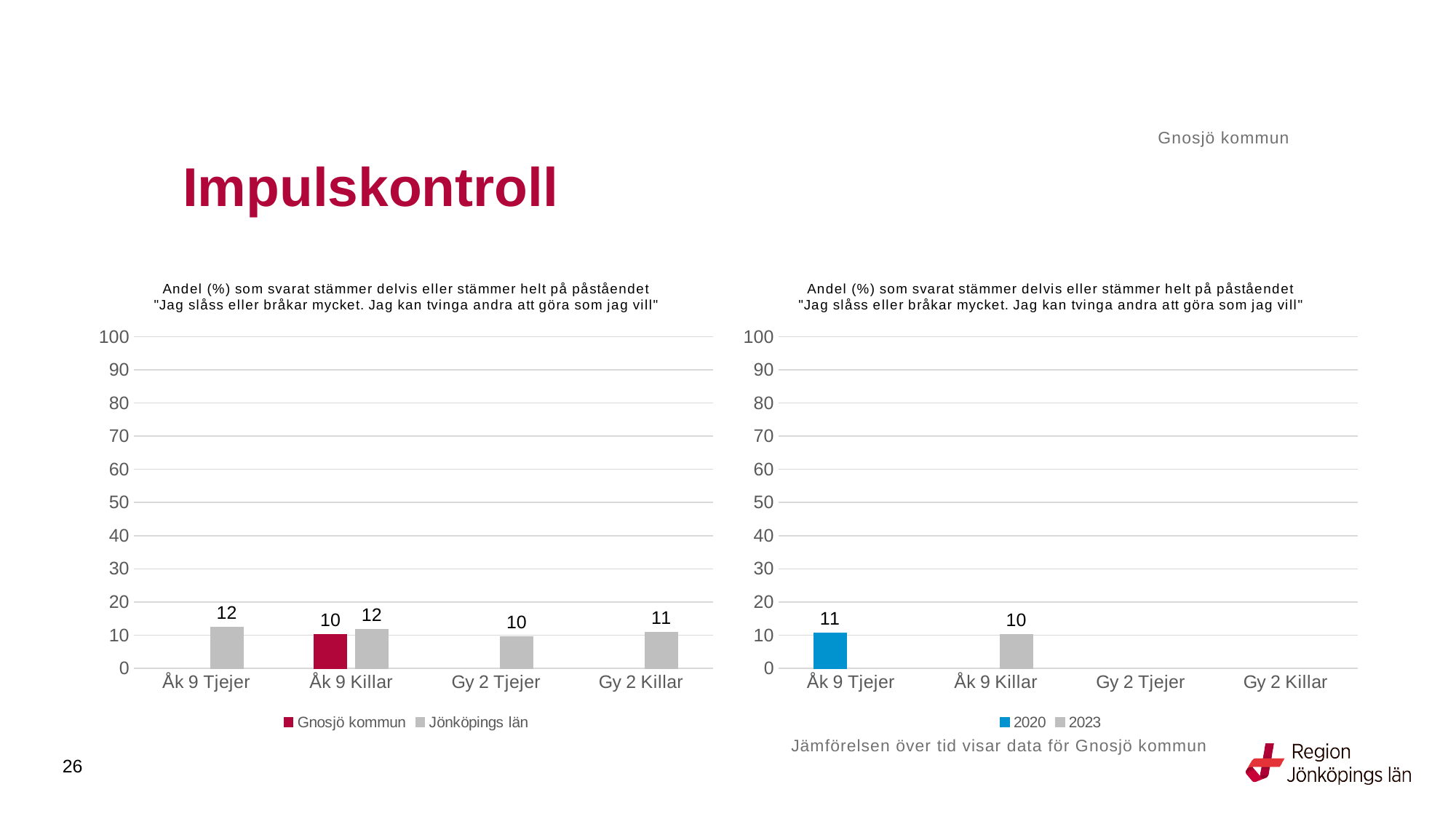
In the left chart, what is the value for Gnosjö kommun for Åk 9 Killar? 10 In the right chart, which is larger: the 2020 value for Åk 9 Tjejer or the 2023 value for Åk 9 Killar? 2020 value for Åk 9 Tjejer What kind of chart is the right chart? bar chart In the left chart, which category has the lowest Jönköpings län value? Gy 2 Tjejer In the left chart, how many series does the legend list? 2 In the right chart, what is the 2020 value for Åk 9 Tjejer? 11 In the left chart, what is the difference between the Jönköpings län value and the Gnosjö kommun value for Åk 9 Killar? 2 In the left chart, what is the value for Jönköpings län for Åk 9 Tjejer? 12 In the left chart, is the Jönköpings län value for Gy 2 Killar greater or less than 20? less In the right chart, what is the 2023 value for Åk 9 Killar? 10 In the left chart, what is the value for Jönköpings län for Gy 2 Killar? 11 In the right chart, which two years does the legend list? 2020 and 2023